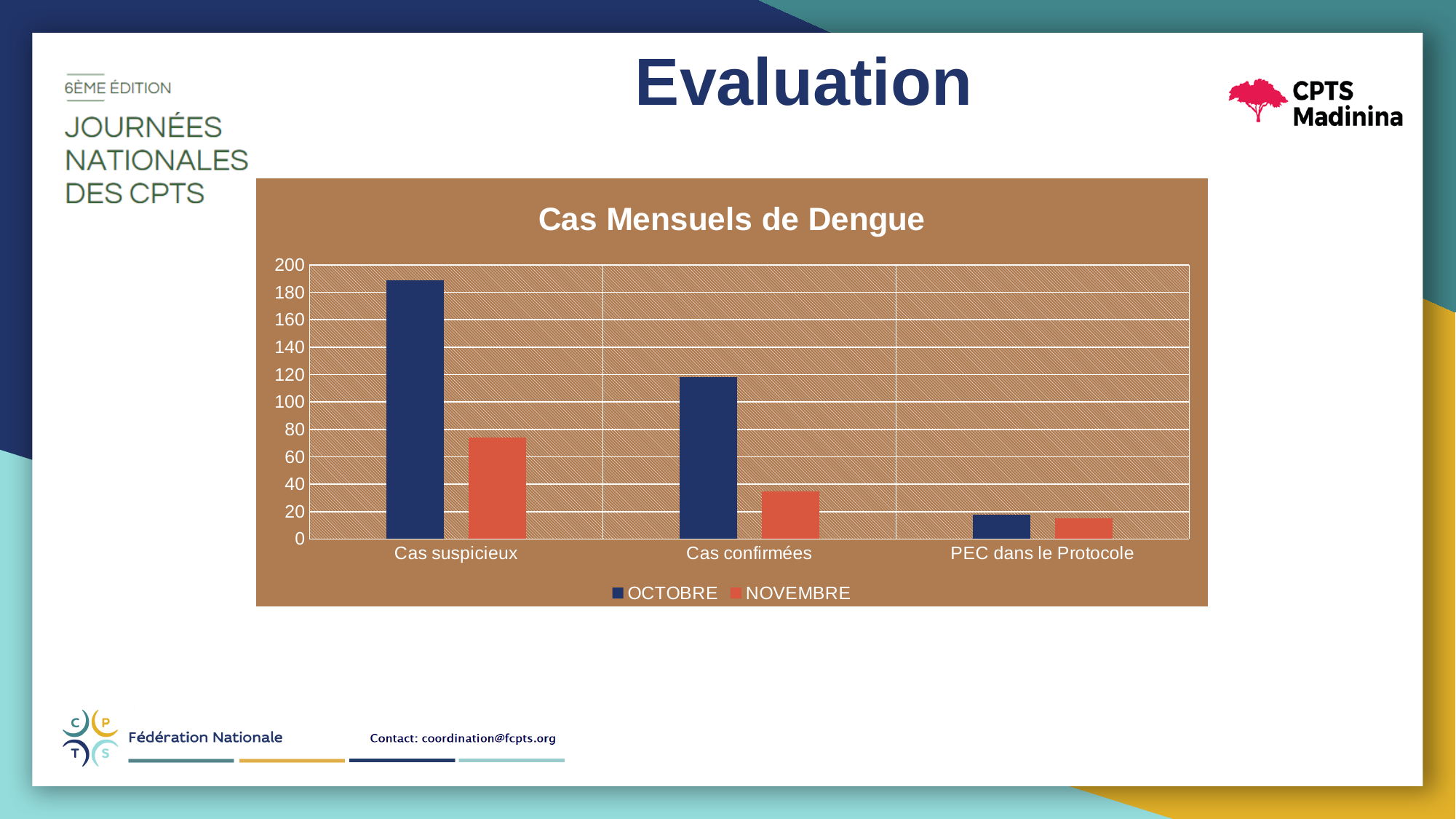
How many series does the legend list? 2 Which is larger for Cas confirmées, the OCTOBRE value or the NOVEMBRE value? OCTOBRE Which category has the highest OCTOBRE value? Cas suspicieux Which category has the lowest NOVEMBRE value? PEC dans le Protocole What type of chart is shown on the slide? bar chart Is the NOVEMBRE value for Cas suspicieux greater or less than 80? less How many categories are shown on the x axis? 3 Which series is shown in orange in the legend? NOVEMBRE Is the NOVEMBRE value for Cas confirmées greater or less than 40? less What is the title of the chart? Cas Mensuels de Dengue Is the OCTOBRE value for Cas suspicieux greater or less than 180? greater